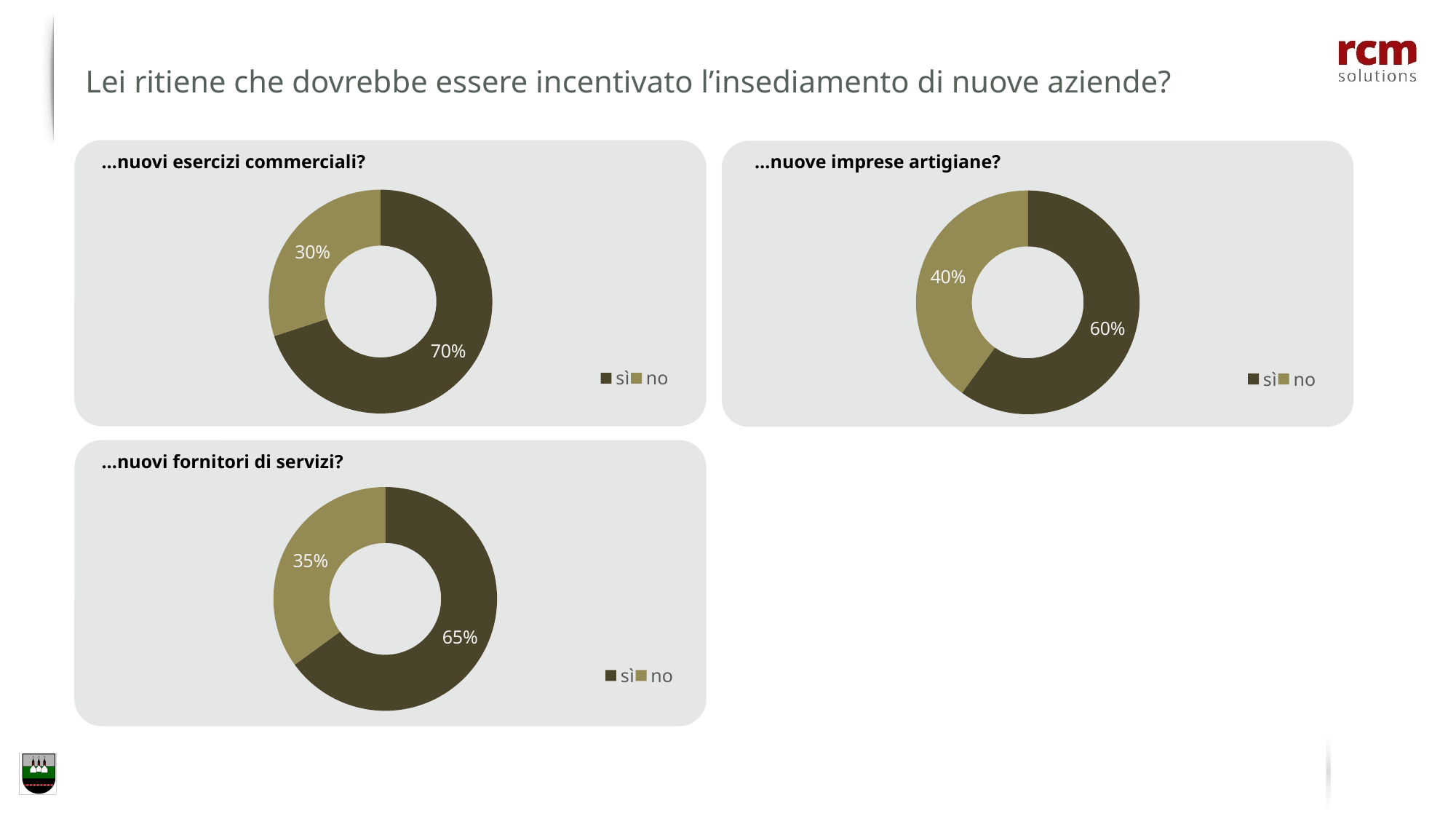
In the '…nuovi esercizi commerciali?' chart, what percentage answered 'sì'? 70% In the '…nuovi fornitori di servizi?' chart, what percentage answered 'sì'? 65% How many entries does the legend of the '…nuove imprese artigiane?' chart list? 2 In the '…nuovi fornitori di servizi?' chart, what percentage answered 'no'? 35% In the '…nuovi fornitori di servizi?' chart, what is the difference between the 'sì' and 'no' shares? 30% What kind of chart is used in the '…nuovi esercizi commerciali?' panel? Doughnut (pie) chart In the '…nuove imprese artigiane?' chart, what percentage answered 'no'? 40% How many charts are shown on the slide? 3 In the '…nuovi esercizi commerciali?' chart, what percentage answered 'no'? 30% In the '…nuovi esercizi commerciali?' chart, what is the difference between the 'sì' and 'no' shares? 40% In the '…nuove imprese artigiane?' chart, what percentage answered 'sì'? 60% In the '…nuove imprese artigiane?' chart, which answer has the larger share, 'sì' or 'no'? sì